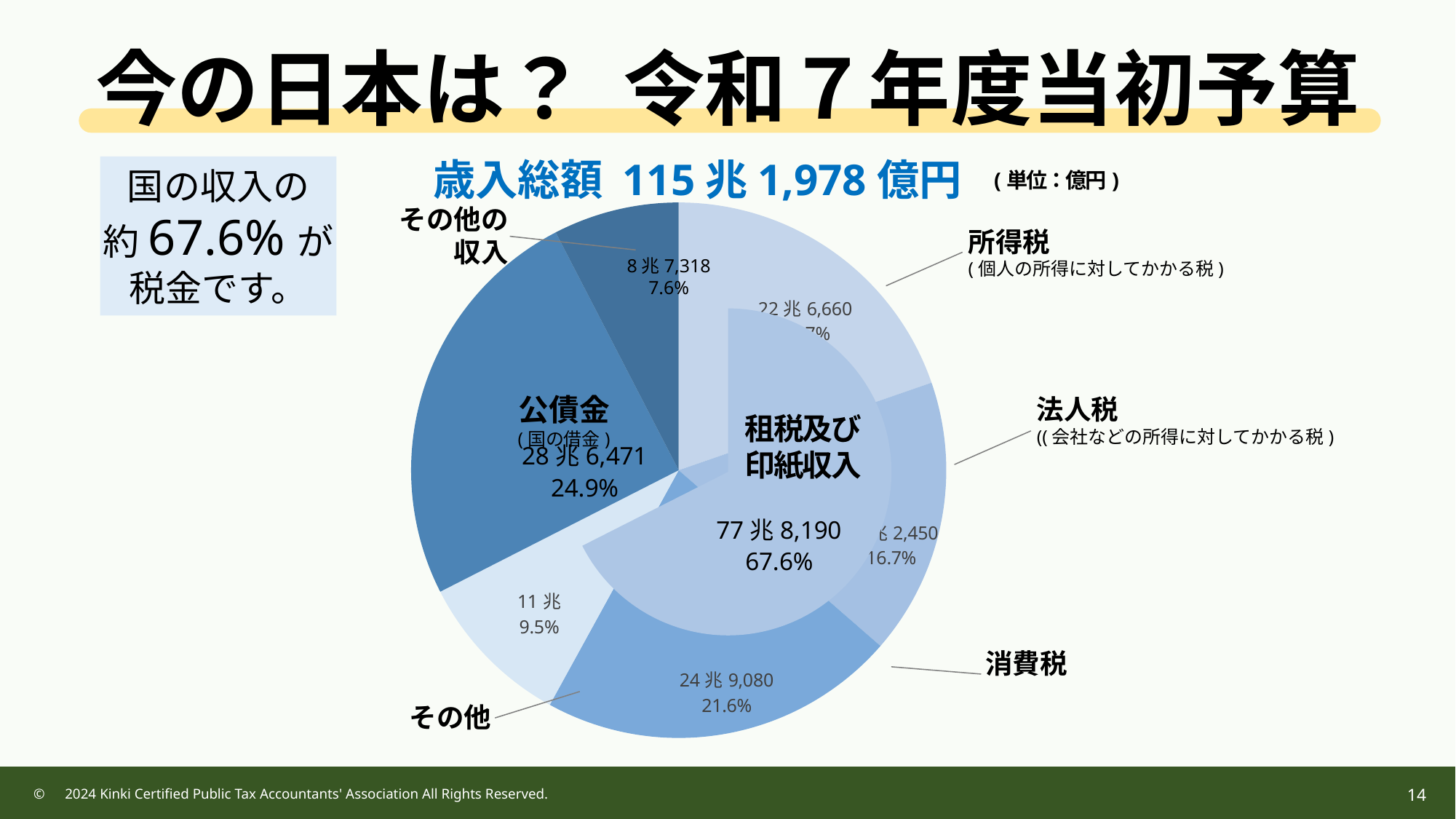
What kind of chart is shown on the slide? pie chart What percentage share is shown for その他の収入? 7.6% What is the value shown for 租税及び印紙収入? 77兆8,190 What is the total revenue (歳入総額) shown above the chart? 115兆1,978億円 What is the value shown for 公債金? 28兆6,471 What is the difference in percentage share between 公債金 and 消費税? 3.3% Which has the larger share, 公債金 or 消費税? 公債金 What is the value shown for 所得税? 22兆6,660 What percentage share is shown for 公債金? 24.9% What percentage share is shown for 消費税? 21.6% What is the value shown for 消費税? 24兆9,080